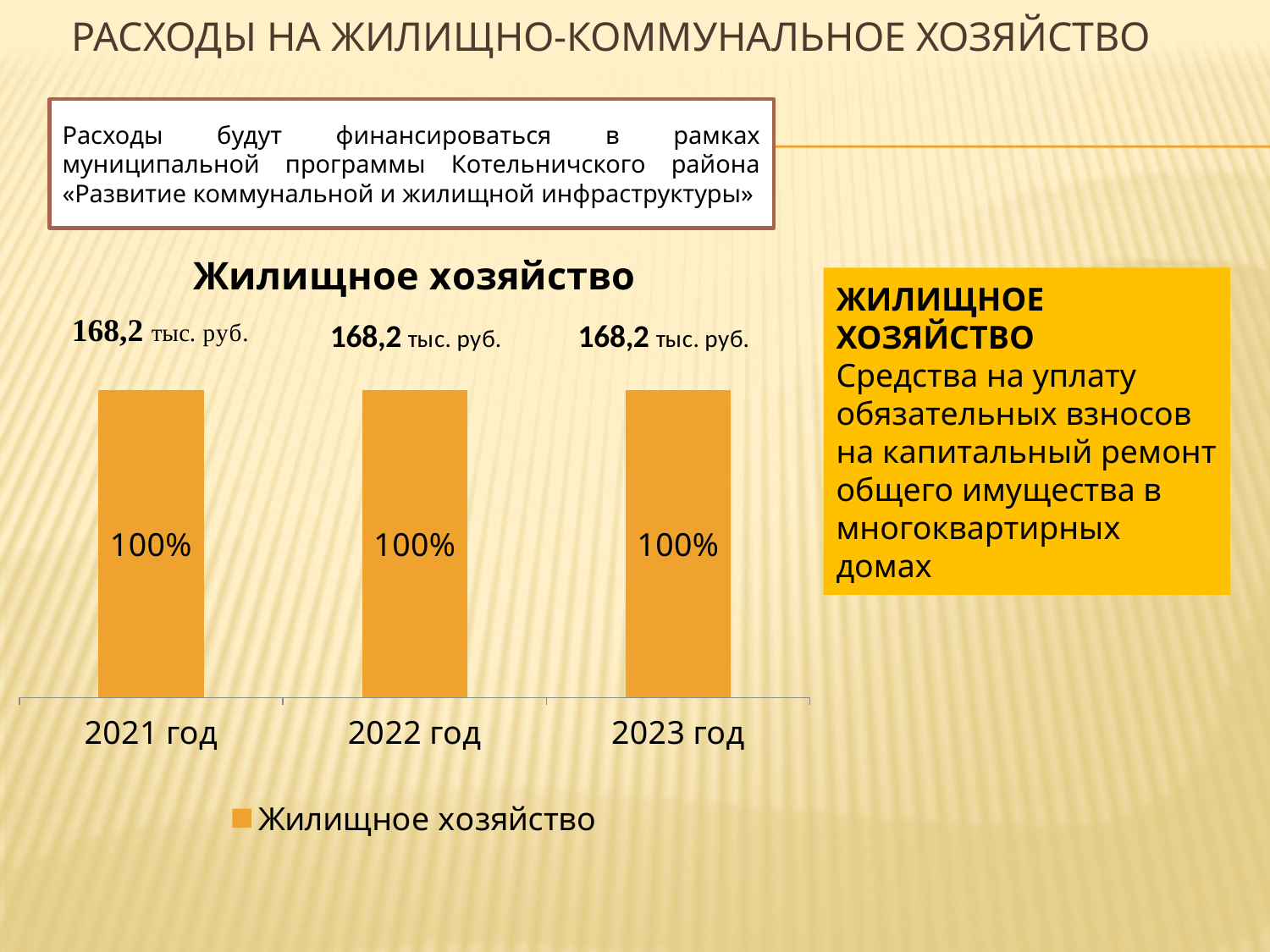
Do the values rise, fall, or stay the same from 2021 год to 2023 год? stay the same What is the difference between the amounts shown for 2021 год and 2023 год? 0 What series name appears in the chart legend? Жилищное хозяйство Is the amount for 2022 год larger than, smaller than, or equal to the amount for 2021 год? equal What amount in тыс. руб. is shown above the bar for 2023 год? 168,2 тыс. руб. What amount in тыс. руб. is shown above the bar for 2022 год? 168,2 тыс. руб. What is the data label shown on the bar for 2021 год? 100% How many bars (categories) are plotted in the chart? 3 What kind of chart is shown on the slide? bar chart What is the data label shown on the bar for 2023 год? 100% How many series does the chart legend list? 1 What is the title of the chart? Жилищное хозяйство